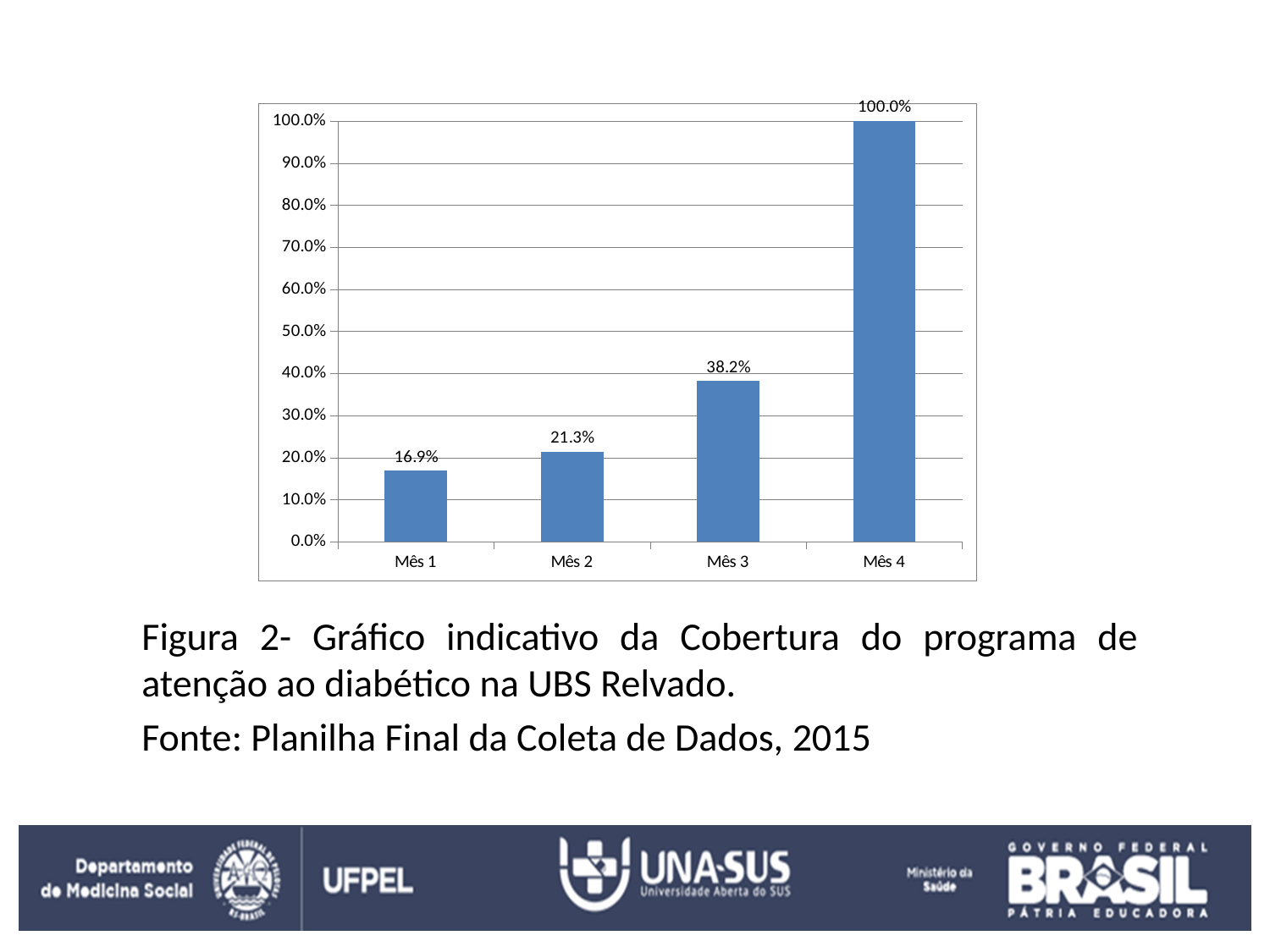
Which month has the highest value? Mês 4 What is the value for Mês 3? 38.2% What kind of chart is shown on the slide? bar chart Which month has the lowest value? Mês 1 What is the difference between the values for Mês 2 and Mês 1? 4.4% Is the value for Mês 3 greater or less than 40.0%? less Which is larger, the value for Mês 2 or the value for Mês 3? Mês 3 What is the difference between the values for Mês 4 and Mês 3? 61.8% What is the value for Mês 4? 100.0% What is the value for Mês 2? 21.3% How many months are shown on the x axis? 4 What is the value for Mês 1? 16.9%